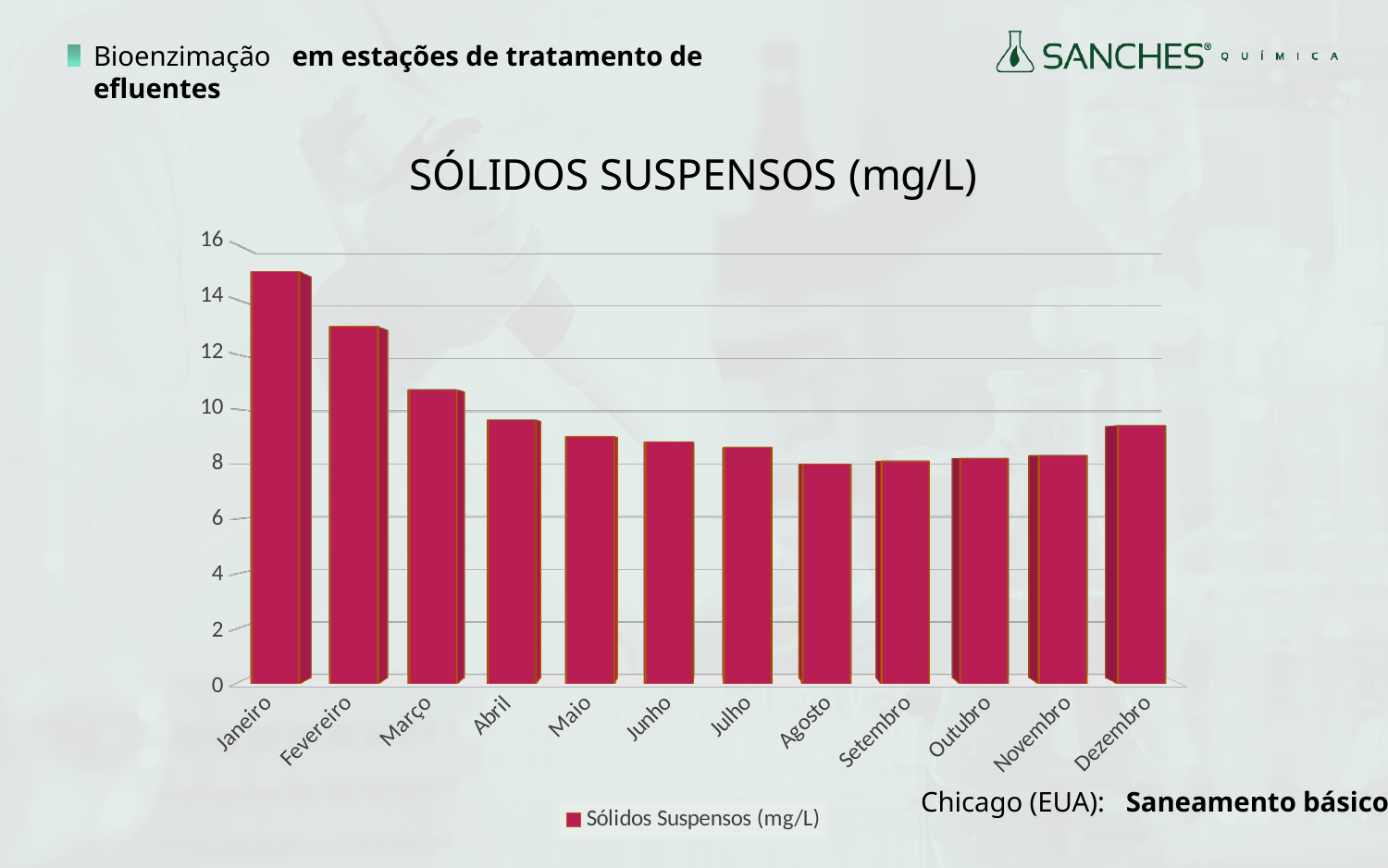
Is the value for Fevereiro greater or less than 14? less Is the value for Abril greater or less than 10? less Is the value for Janeiro greater or less than 14? greater Do the values rise or fall from Janeiro to Agosto? fall How many series does the legend list? 1 What kind of chart is shown on the slide? bar chart Which month has the highest value for Sólidos Suspensos? Janeiro Which is larger, the value for Março or the value for Dezembro? Março What is the title of the chart? SÓLIDOS SUSPENSOS (mg/L) How many months (categories) are plotted on the x axis? 12